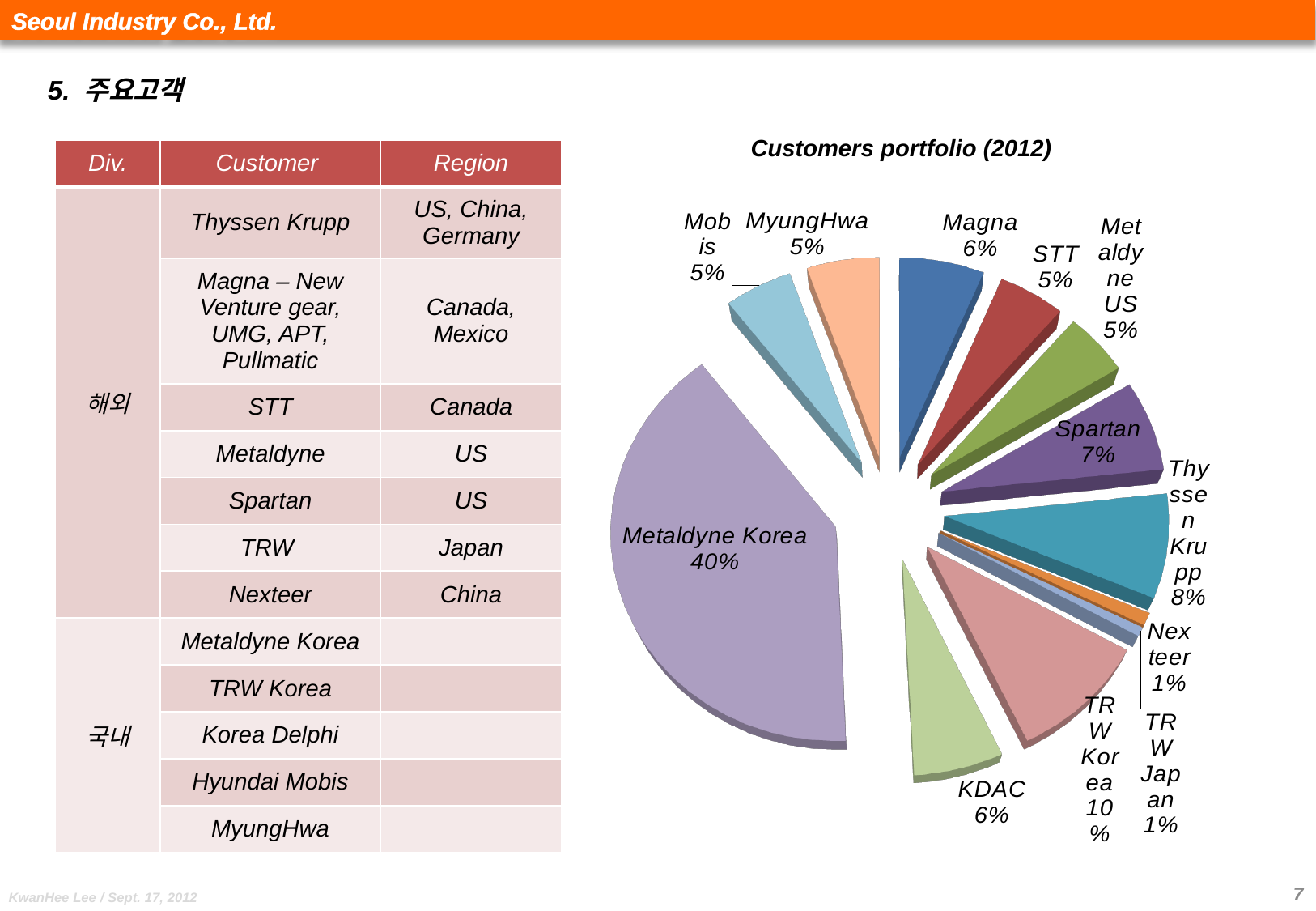
Which customer has the largest slice of the pie? Metaldyne Korea What share of the pie does Metaldyne Korea hold? 40% What is the difference in share between Spartan and STT? 2% What is the title of the chart? Customers portfolio (2012) What share of the pie does Spartan hold? 7% Which has a larger share, Thyssen Krupp or Magna? Thyssen Krupp What kind of chart is shown on the slide? pie chart How many slices does the pie chart have? 12 What share of the pie does TRW Korea hold? 10% What share of the pie does Nexteer hold? 1% What share of the pie does Thyssen Krupp hold? 8% What is the difference in share between Metaldyne Korea and TRW Korea? 30%